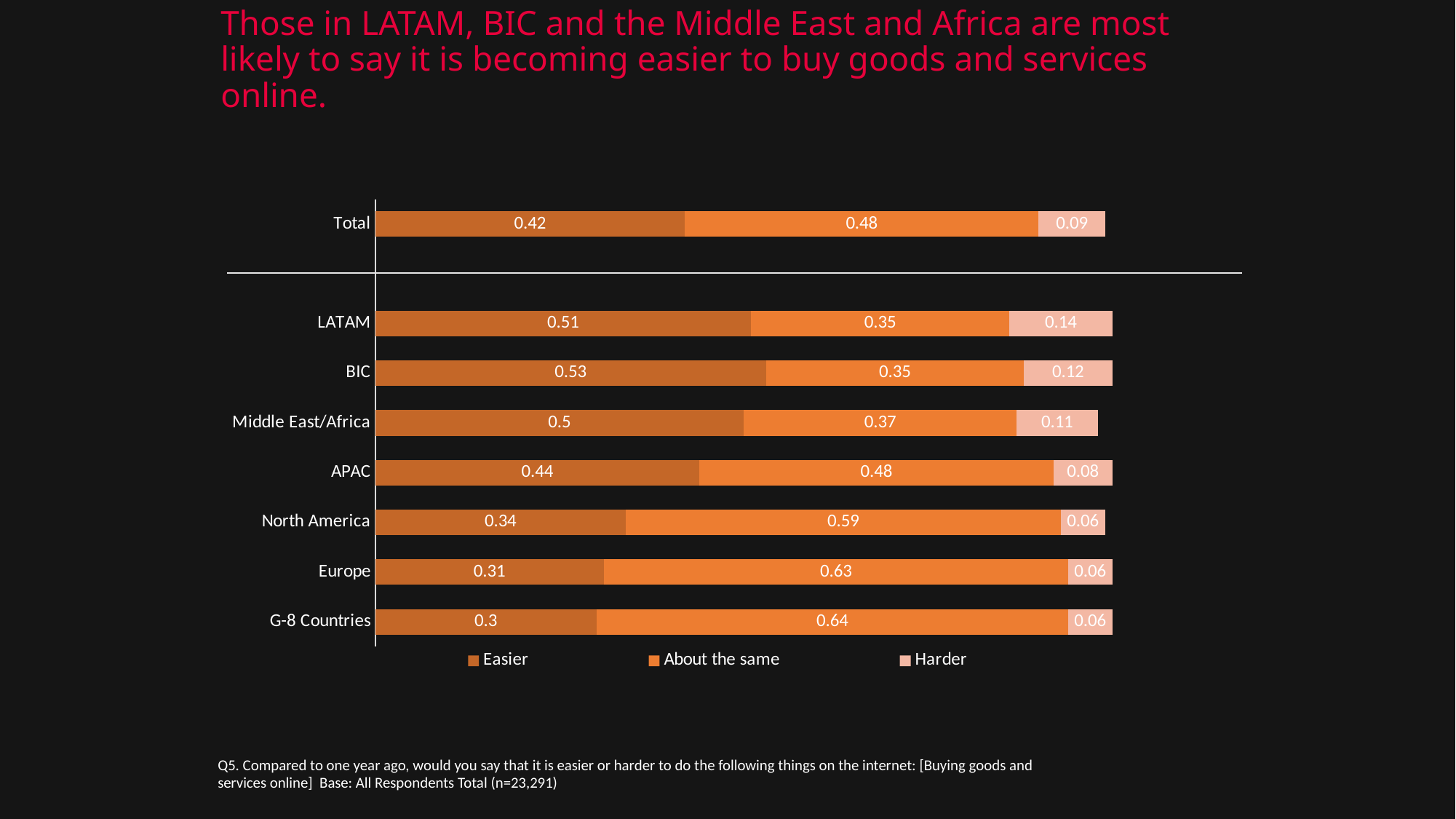
Which category has the highest 'Easier' value? BIC Which category has the lowest 'Easier' value? G-8 Countries What is the 'Harder' value for Total? 0.09 What is the 'Easier' value for LATAM? 0.51 Which category has the highest 'Harder' value? LATAM What is the difference between the 'Easier' values for BIC and Europe? 0.22 Which is larger, the 'About the same' value for North America or for APAC? North America What are the three legend entries on the chart? Easier, About the same, Harder How many categories are shown on the chart? 8 How many series does the legend list? 3 What kind of chart is shown on the slide? Stacked bar chart What is the 'About the same' value for North America? 0.59